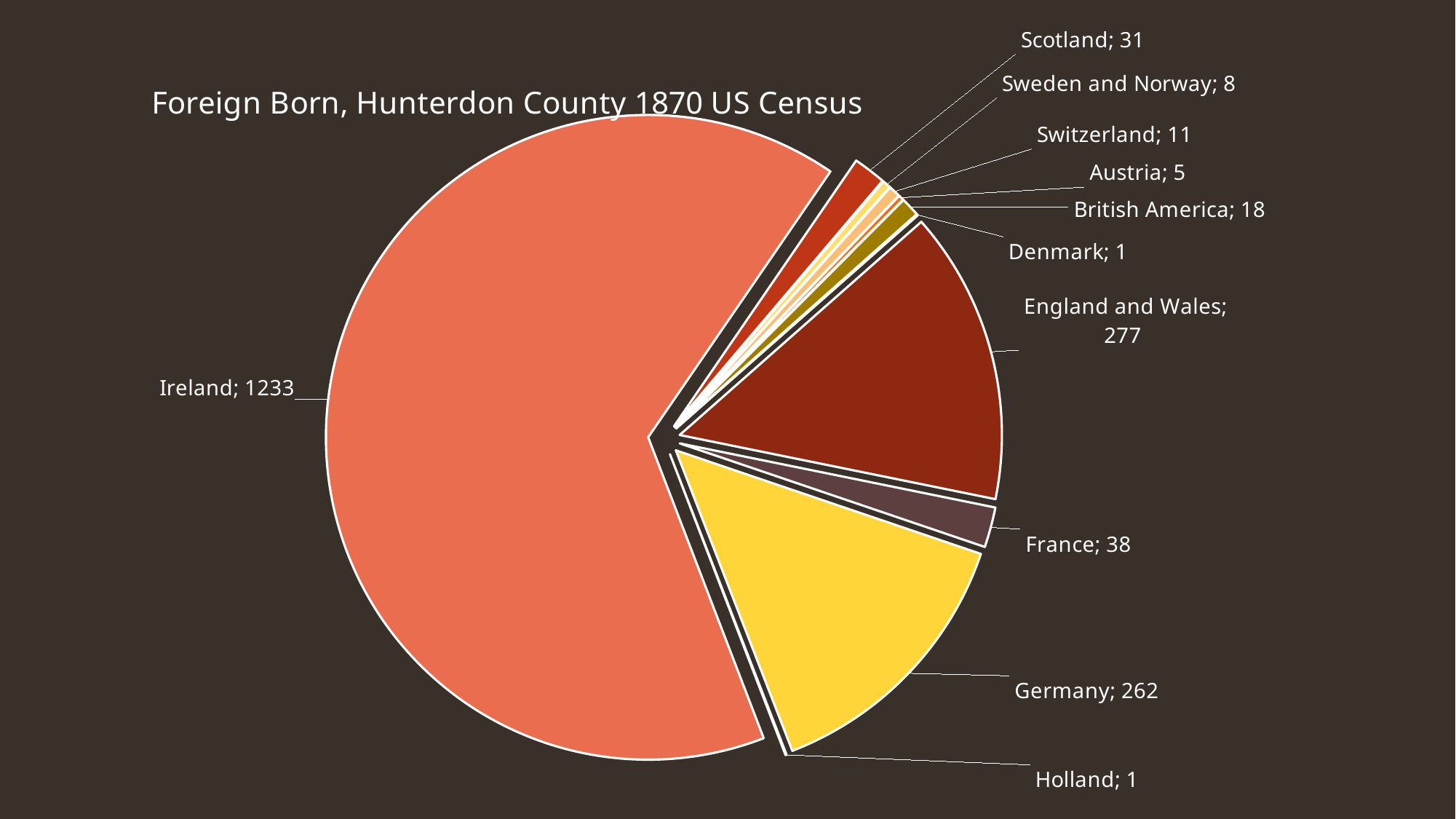
What is the value for England and Wales? 277 What is the value for Germany? 262 How many foreign-born people from Ireland are shown in the chart? 1233 What is the title of the chart? Foreign Born, Hunterdon County 1870 US Census What kind of chart is shown on the slide? pie chart Which is larger, the value for Austria or the value for British America? British America Which country of origin has the largest slice of the pie? Ireland Which is larger, the value for Switzerland or the value for Sweden and Norway? Switzerland What is the value for British America? 18 What is the difference between the values for England and Wales and Germany? 15 How many categories (countries of origin) does the pie chart show? 11 What is the difference between the values for France and Scotland? 7